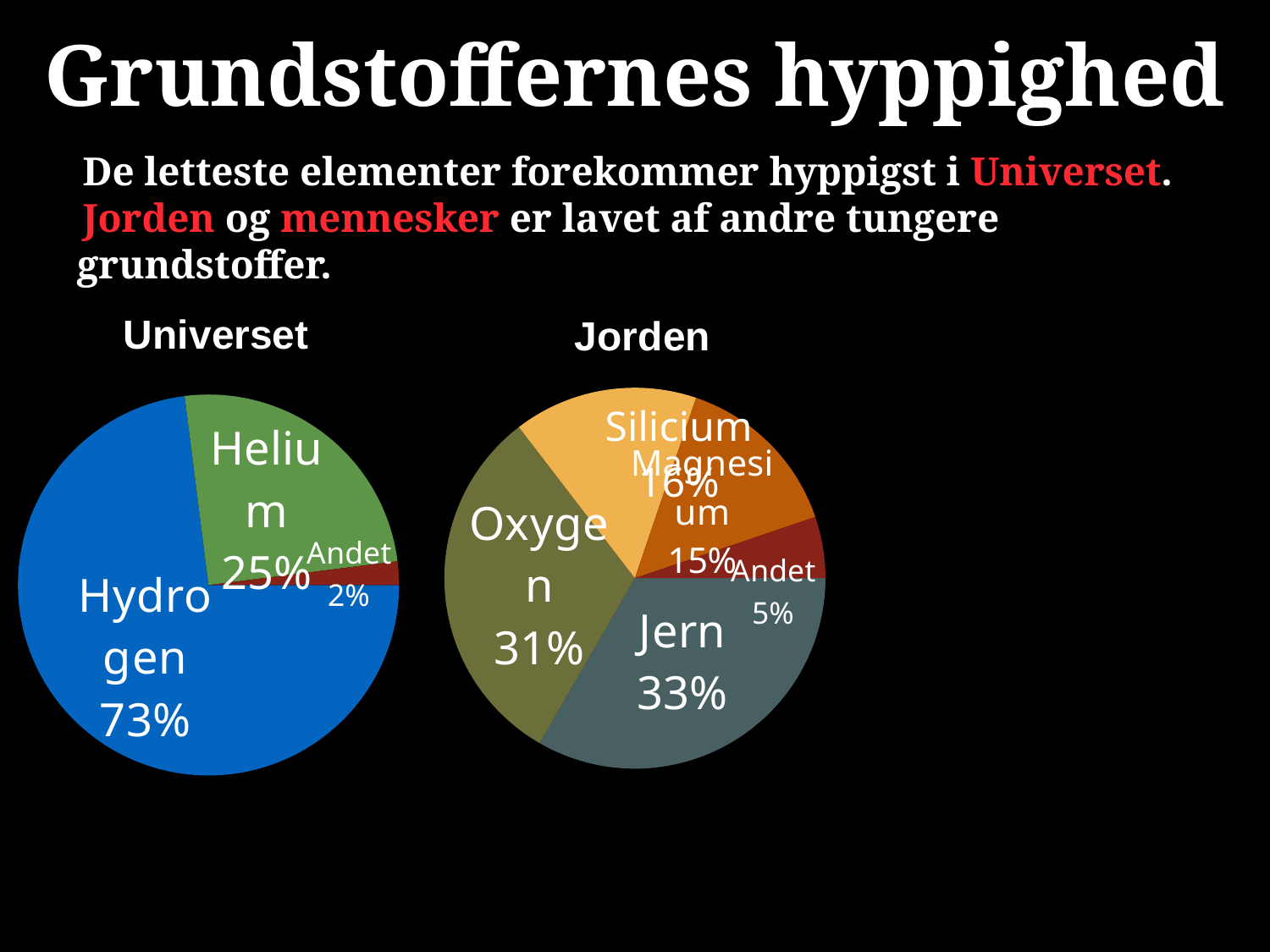
In the Universet pie chart, what share does Helium have? 25% In the Jorden pie chart, how many slices are there? 5 In the Universet pie chart, which slice is the largest? Hydrogen In the Jorden pie chart, which slice is the smallest? Andet In the Jorden pie chart, what share does Oxygen have? 31% In the Universet pie chart, what share does Andet have? 2% What kind of charts are shown on the slide? Pie charts In the Universet pie chart, how many slices are there? 3 In the Jorden pie chart, what share does Silicium have? 16% In the Jorden pie chart, what share does Jern have? 33% In the Universet pie chart, what share does Hydrogen have? 73% In the Jorden pie chart, what is the difference between the shares of Jern and Oxygen? 2%